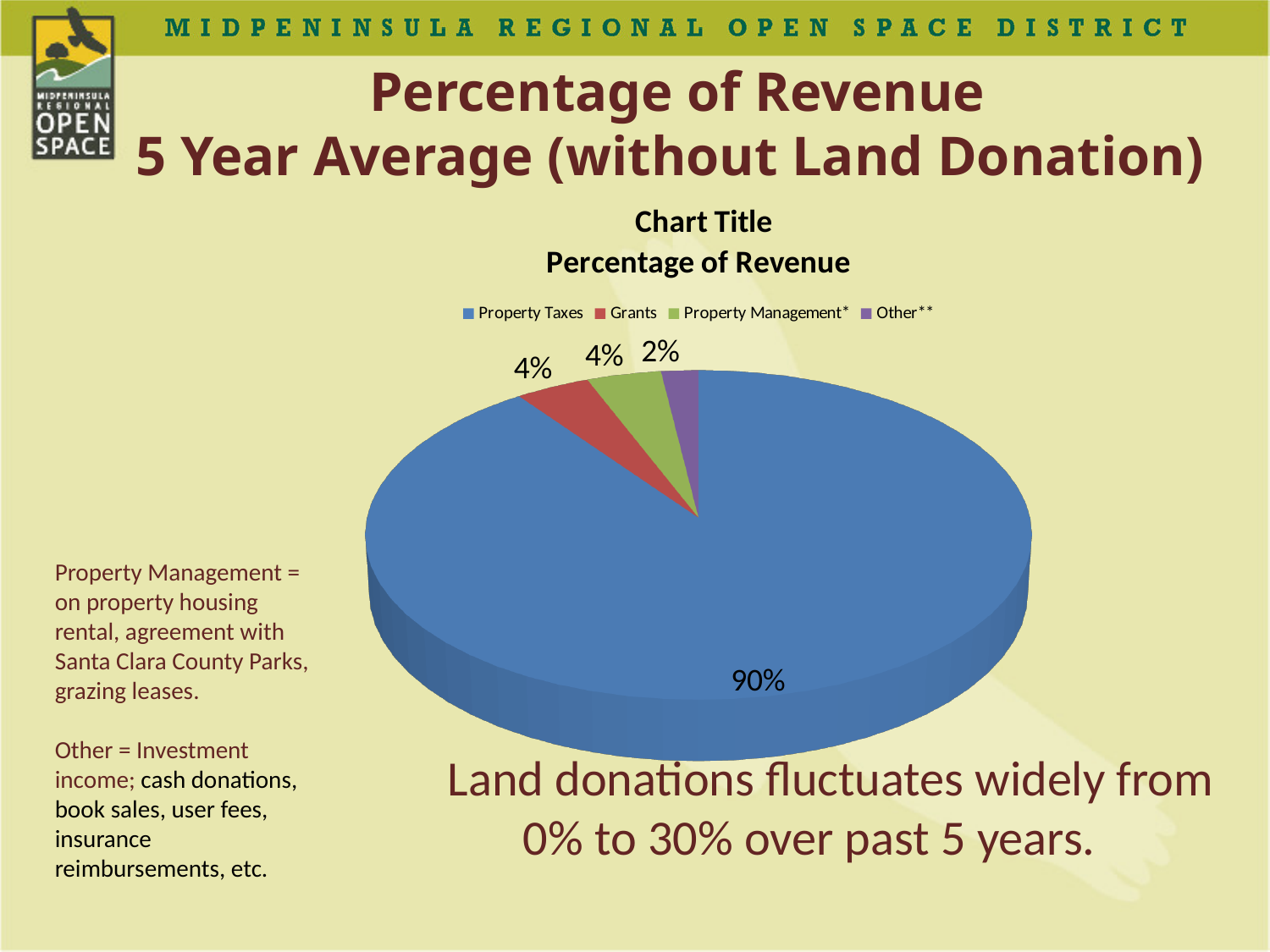
What percentage of revenue comes from Property Management? 4% What percentage of revenue comes from Other? 2% What is the difference in percentage points between Property Taxes and Grants? 86 What kind of chart is shown on the slide? Pie chart Which revenue category has the smallest share of the pie? Other What colour is the Property Taxes slice of the pie? Blue How many entries does the chart legend list? 4 Which is larger, the share for Grants or the share for Other? Grants Which revenue category has the largest share of the pie? Property Taxes What percentage of revenue comes from Property Taxes? 90% How many categories does the pie chart show? 4 What percentage of revenue comes from Grants? 4%